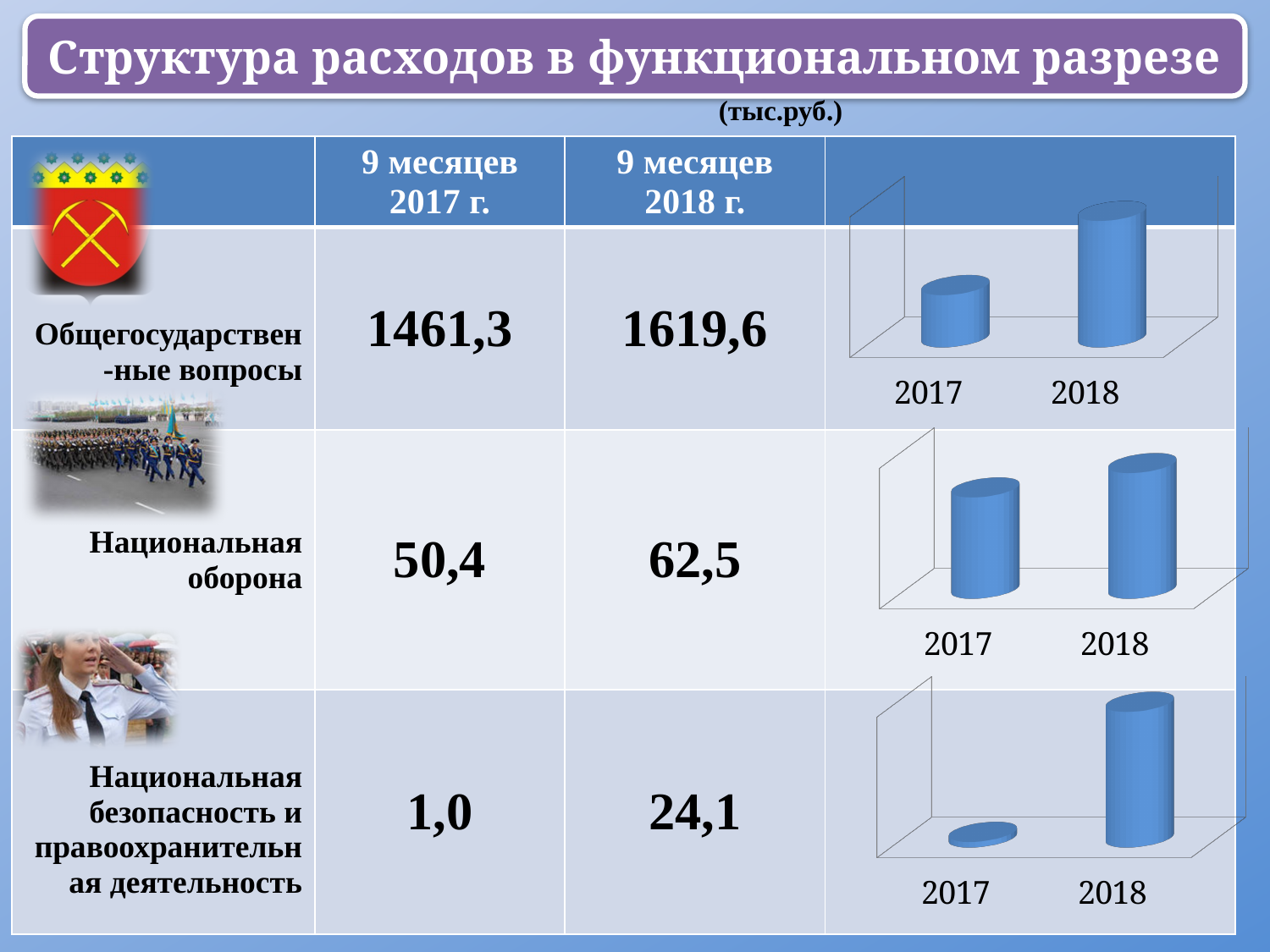
What unit is stated for the values on the slide? тыс.руб. In the top chart (Общегосударственные вопросы), which year has the taller bar? 2018 In the top chart (Общегосударственные вопросы), what is the difference between the 2018 and 2017 values? 158,3 In the middle chart (Национальная оборона), by how much does the 2018 value exceed the 2017 value? 12,1 In the bottom chart (Национальная безопасность и правоохранительная деятельность), do the values rise or fall from 2017 to 2018? rise How many categories does the chart in the top row (Общегосударственные вопросы) show? 2 In the middle chart (Национальная оборона), is the 2017 bar or the 2018 bar larger? 2018 In the middle chart (Национальная оборона), what is the value for 2018? 62,5 What kind of chart is shown in the top row next to 'Общегосударственные вопросы'? bar chart In the top chart (Общегосударственные вопросы), what is the value for 2017? 1461,3 In the bottom chart (Национальная безопасность и правоохранительная деятельность), which year has the lowest value? 2017 In the bottom chart (Национальная безопасность и правоохранительная деятельность), what is the value for 2017? 1,0